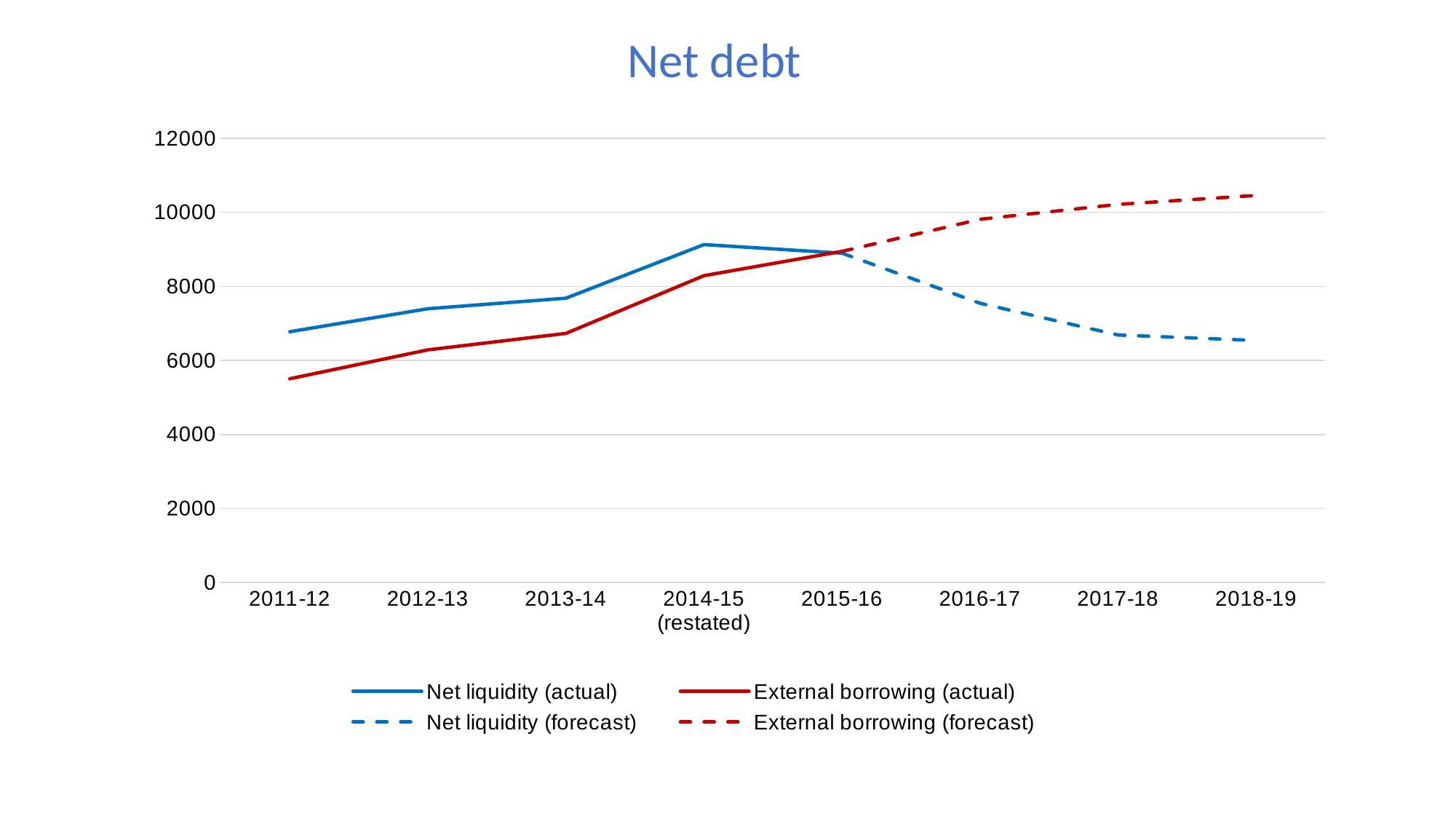
Is the value for Net liquidity (forecast) in 2018-19 greater or less than 8000? less Is the value for External borrowing (forecast) in 2018-19 greater or less than 10000? greater How many series does the legend list? 4 In 2011-12, which is larger: Net liquidity (actual) or External borrowing (actual)? Net liquidity (actual) In 2018-19, which is larger: Net liquidity (forecast) or External borrowing (forecast)? External borrowing (forecast) Does External borrowing (actual) rise or fall from 2011-12 to 2015-16? rise What kind of chart is shown on the slide? line chart Is the value for Net liquidity (actual) in 2014-15 (restated) greater or less than 8000? greater How many financial years are shown on the x axis? 8 What is the title of the chart? Net debt Does Net liquidity (forecast) rise or fall from 2016-17 to 2018-19? fall